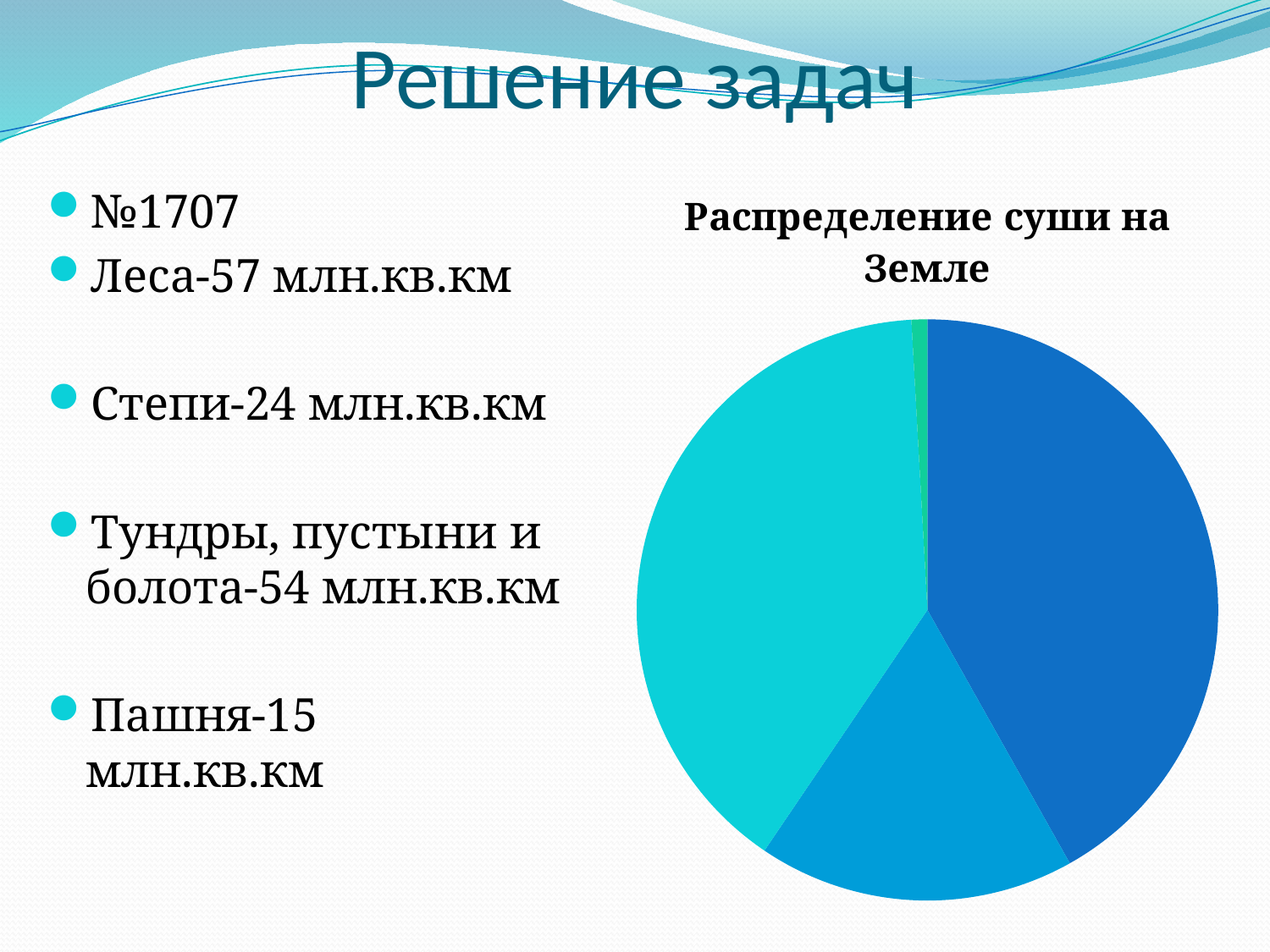
Does the pie chart display a legend? No Is the dark blue slice of the pie chart larger or smaller than the light blue slice? larger According to the slide text, what is the area of Тундры, пустыни и болота? 54 млн.кв.км What colour is the largest slice of the pie chart? dark blue According to the slide text, what is the area of Степи? 24 млн.кв.км What kind of chart is shown on the slide? pie chart Is the teal slice of the pie chart larger or smaller than the light blue slice? larger What is the title of the pie chart? Распределение суши на Земле According to the slide text, what is the area of Пашня? 15 млн.кв.км According to the slide text, what is the area of Леса? 57 млн.кв.км According to the slide text, which land type has the smallest area? Пашня According to the slide text, which land type has the largest area? Леса